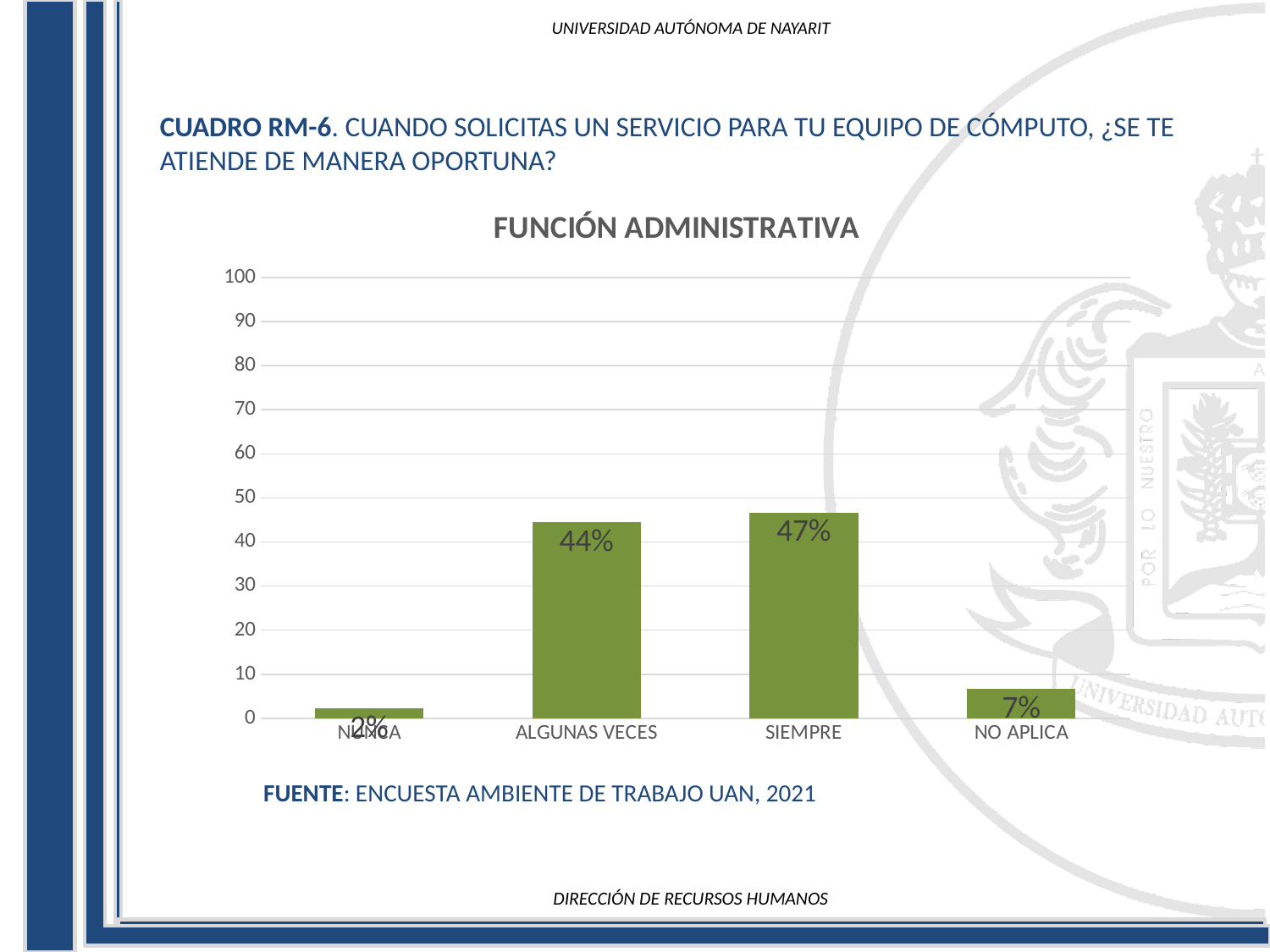
What is the difference between the values for SIEMPRE and ALGUNAS VECES? 3% Which category has the lowest value? NUNCA What is the value for SIEMPRE? 47% What is the difference between the values for ALGUNAS VECES and NO APLICA? 37% Which category has the highest value? SIEMPRE Is the value for SIEMPRE greater or less than 50? less Which is larger, the value for NO APLICA or the value for NUNCA? NO APLICA What kind of chart is shown on the slide? bar chart What is the value for ALGUNAS VECES? 44% What is the title of the chart? FUNCIÓN ADMINISTRATIVA How many categories are shown on the x axis? 4 What is the value for NO APLICA? 7%